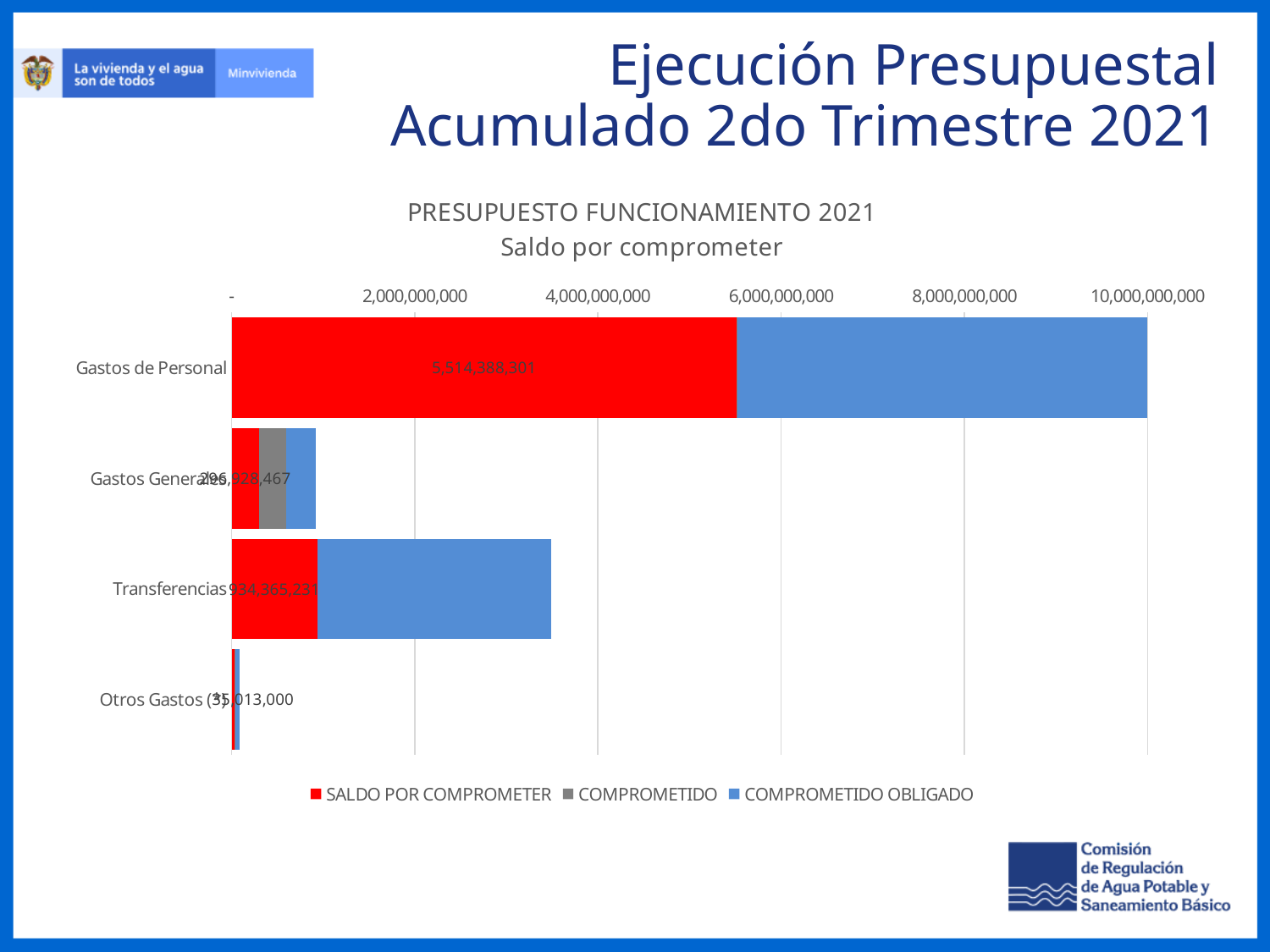
Which has the larger SALDO POR COMPROMETER segment, Gastos de Personal or Transferencias? Gastos de Personal Which category has the shortest total bar? Otros Gastos What kind of chart is shown on the slide? bar chart Which category has the longest total bar? Gastos de Personal Is the total bar for Gastos Generales greater or less than 2,000,000,000? less How many series does the legend list? 3 Which colour represents SALDO POR COMPROMETER in the legend? red Which has the larger total bar, Transferencias or Gastos Generales? Transferencias Is the SALDO POR COMPROMETER value for Gastos de Personal greater or less than 4,000,000,000? greater What is the SALDO POR COMPROMETER value for Gastos de Personal? 5,514,388,301 How many categories are plotted on the chart? 4 Is the total bar for Transferencias greater or less than 4,000,000,000? less